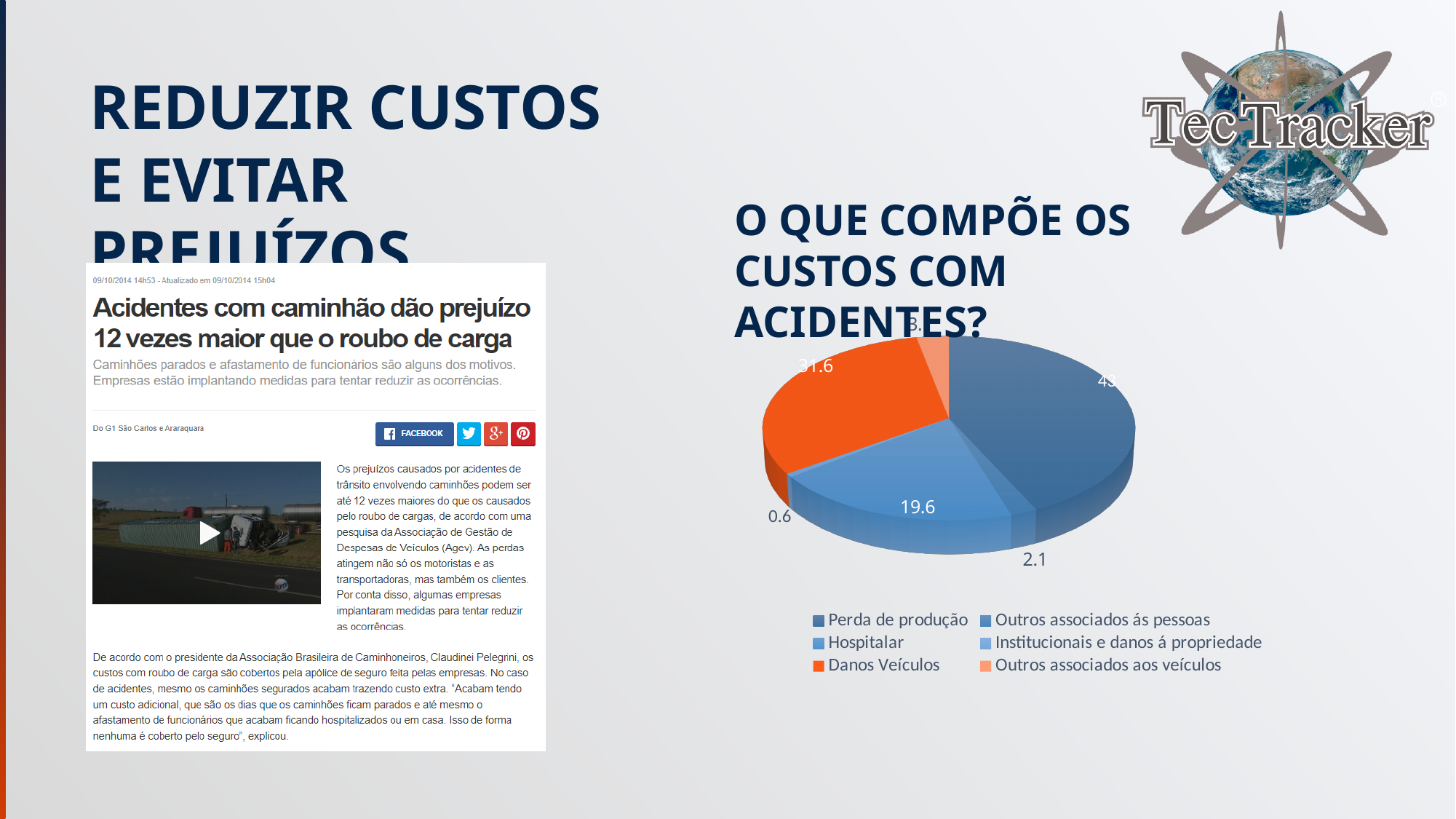
What colour is the Danos Veículos slice? orange What is the value shown for Danos Veículos? 31.6 How many categories does the pie chart's legend list? 6 What is the value shown for Outros associados ás pessoas? 2.1 What is the value shown for Institucionais e danos á propriedade? 0.6 What is the difference between the values for Danos Veículos and Hospitalar? 12 What kind of chart is shown on the slide? pie chart Which is larger, Danos Veículos or Hospitalar? Danos Veículos What is the value shown for Hospitalar? 19.6 Which category has the largest slice of the pie? Perda de produção Which category has the smallest slice of the pie? Institucionais e danos á propriedade What is the title of the pie chart? O QUE COMPÕE OS CUSTOS COM ACIDENTES?